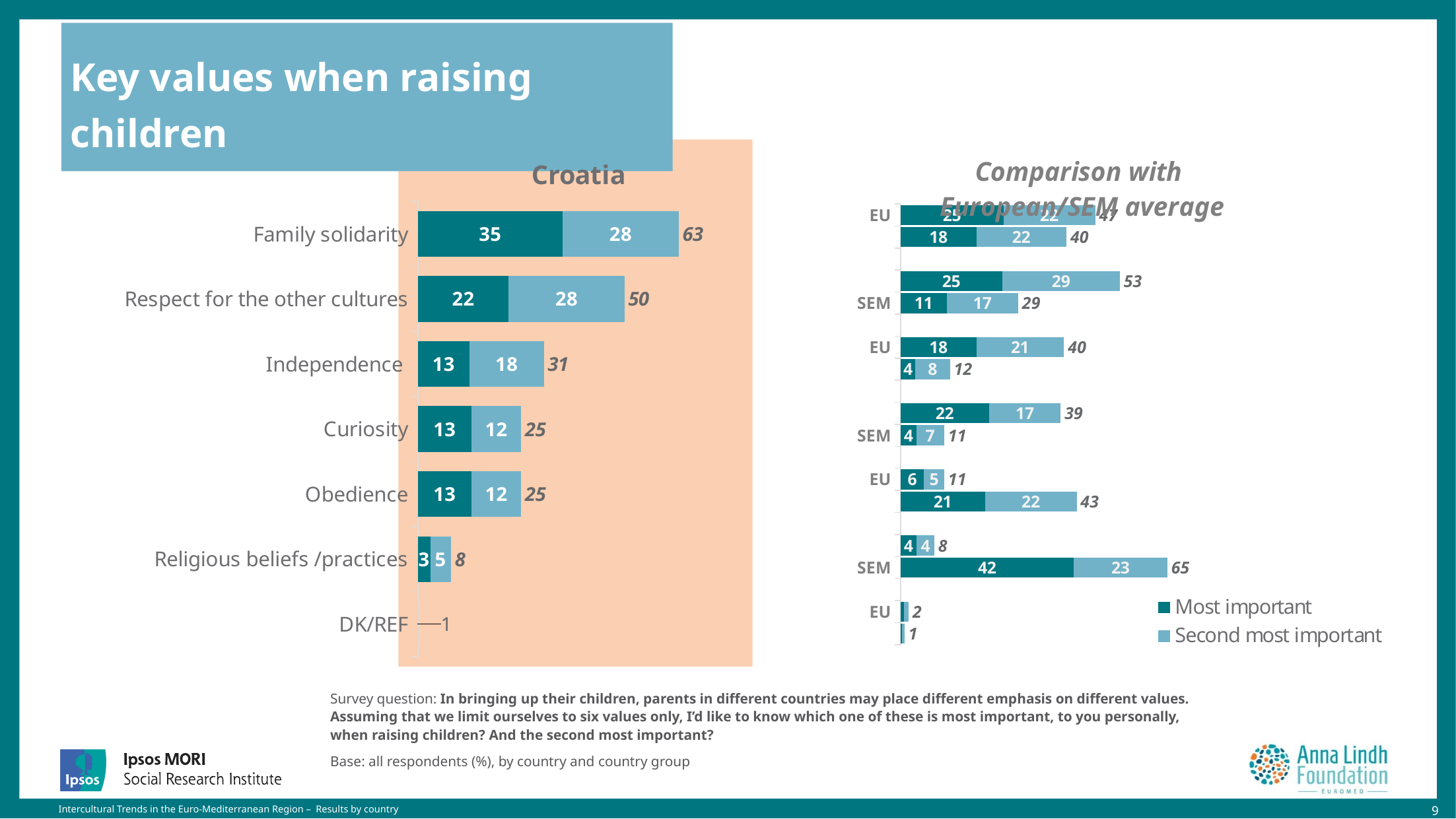
How many series does the legend list? 2 In the Croatia chart, which value has the lowest total, excluding DK/REF? Religious beliefs /practices In the Croatia chart, what is the value shown for DK/REF? 1 In the Comparison with European/SEM average chart, what is the largest 'Most important' value shown? 42 In the Croatia chart, which is larger: the 'Most important' value for Family solidarity or for Respect for the other cultures? Family solidarity In the Croatia chart, what is the total shown for Respect for the other cultures? 50 In the Croatia chart, what is the difference between the totals for Family solidarity and Respect for the other cultures? 13 In the Croatia chart, what is the 'Most important' value for Family solidarity? 35 In the Croatia chart, which value has the highest total? Family solidarity What kind of chart is the Croatia chart? Stacked bar chart How many categories are shown in the Croatia chart, including DK/REF? 7 In the Croatia chart, what is the 'Second most important' value for Independence? 18